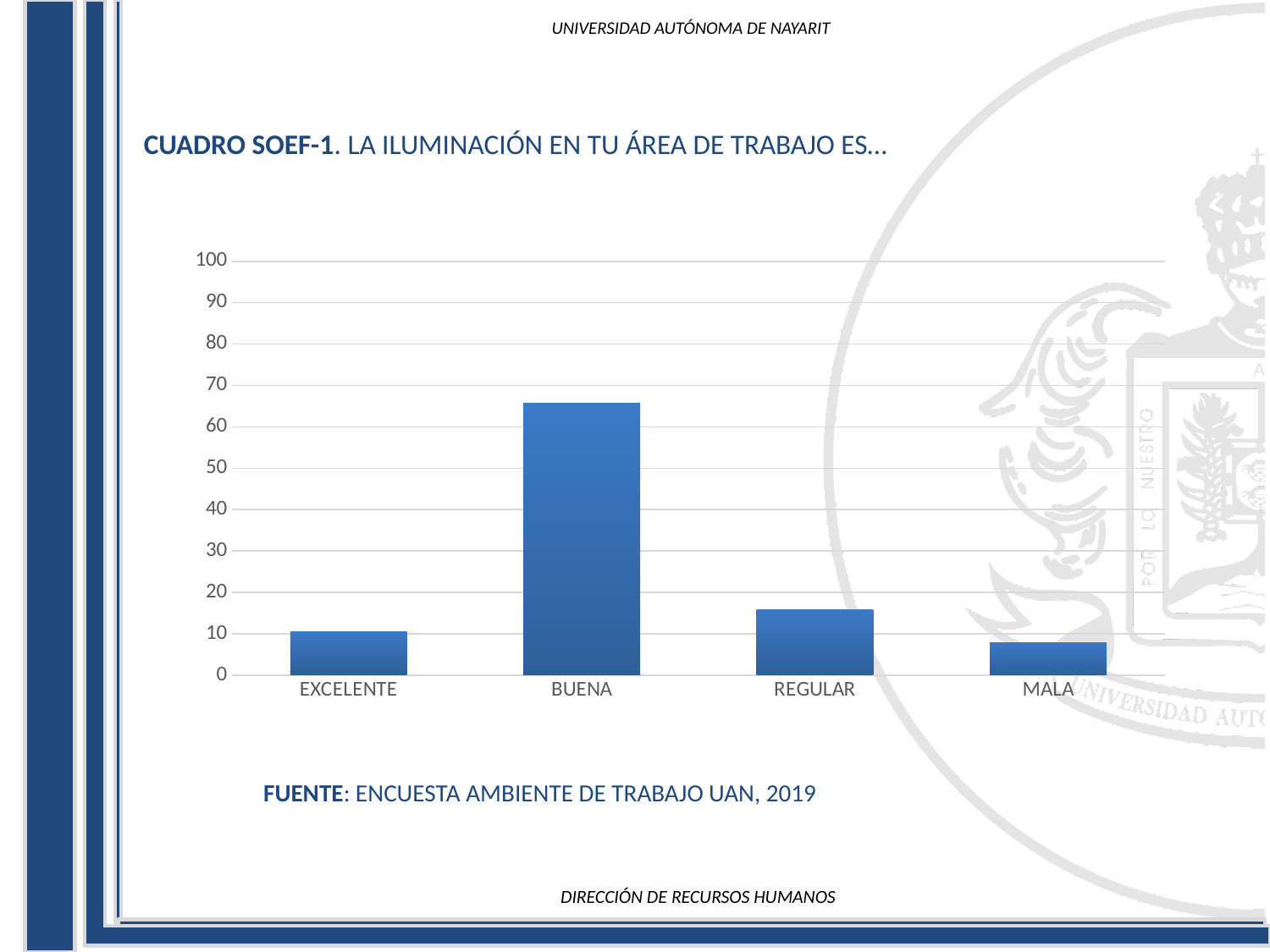
Is the value for REGULAR greater or less than 10? greater Which is larger, the value for REGULAR or the value for EXCELENTE? REGULAR Which category has the lowest value in the chart? MALA Is the value for BUENA greater or less than 60? greater What is the title of the chart on the slide? CUADRO SOEF-1. LA ILUMINACIÓN EN TU ÁREA DE TRABAJO ES… What kind of chart is shown on the slide? bar chart Is the value for BUENA greater or less than 70? less How many categories are shown on the x axis of the chart? 4 Which category has the highest value in the chart? BUENA Which is larger, the value for BUENA or the value for REGULAR? BUENA